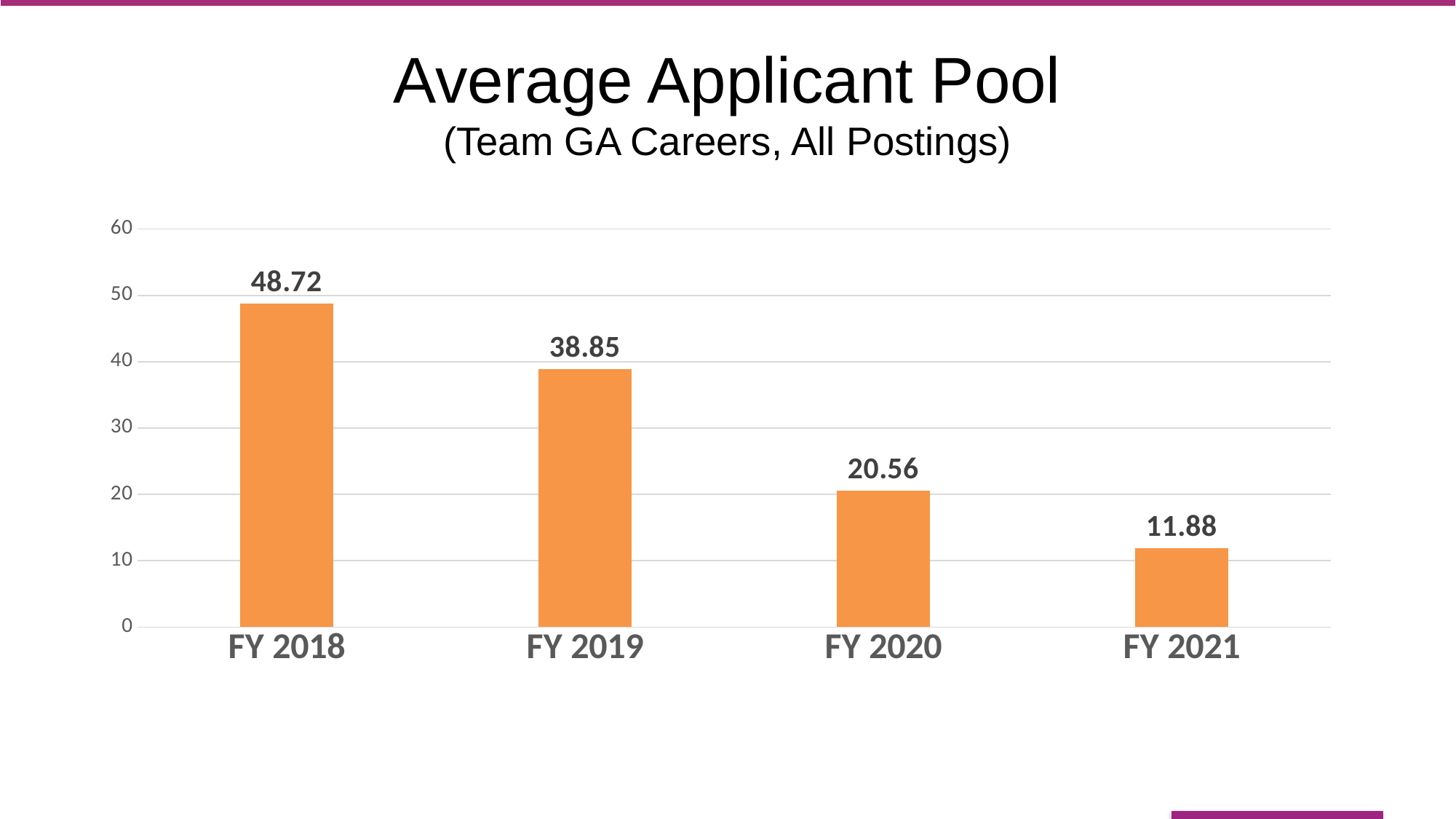
Do the values rise or fall from FY 2018 to FY 2021? Fall What is the value shown for FY 2021? 11.88 How many fiscal years are shown on the chart? 4 What is the difference between the FY 2018 and FY 2019 values? 9.87 What is the average applicant pool for FY 2018? 48.72 Which is larger, the value for FY 2019 or the value for FY 2020? FY 2019 What kind of chart is shown on the slide? Bar chart Which fiscal year has the highest average applicant pool? FY 2018 What is the difference between the FY 2020 and FY 2021 values? 8.68 Which fiscal year has the lowest average applicant pool? FY 2021 What is the average applicant pool for FY 2020? 20.56 Is the value for FY 2019 greater or less than 40? less